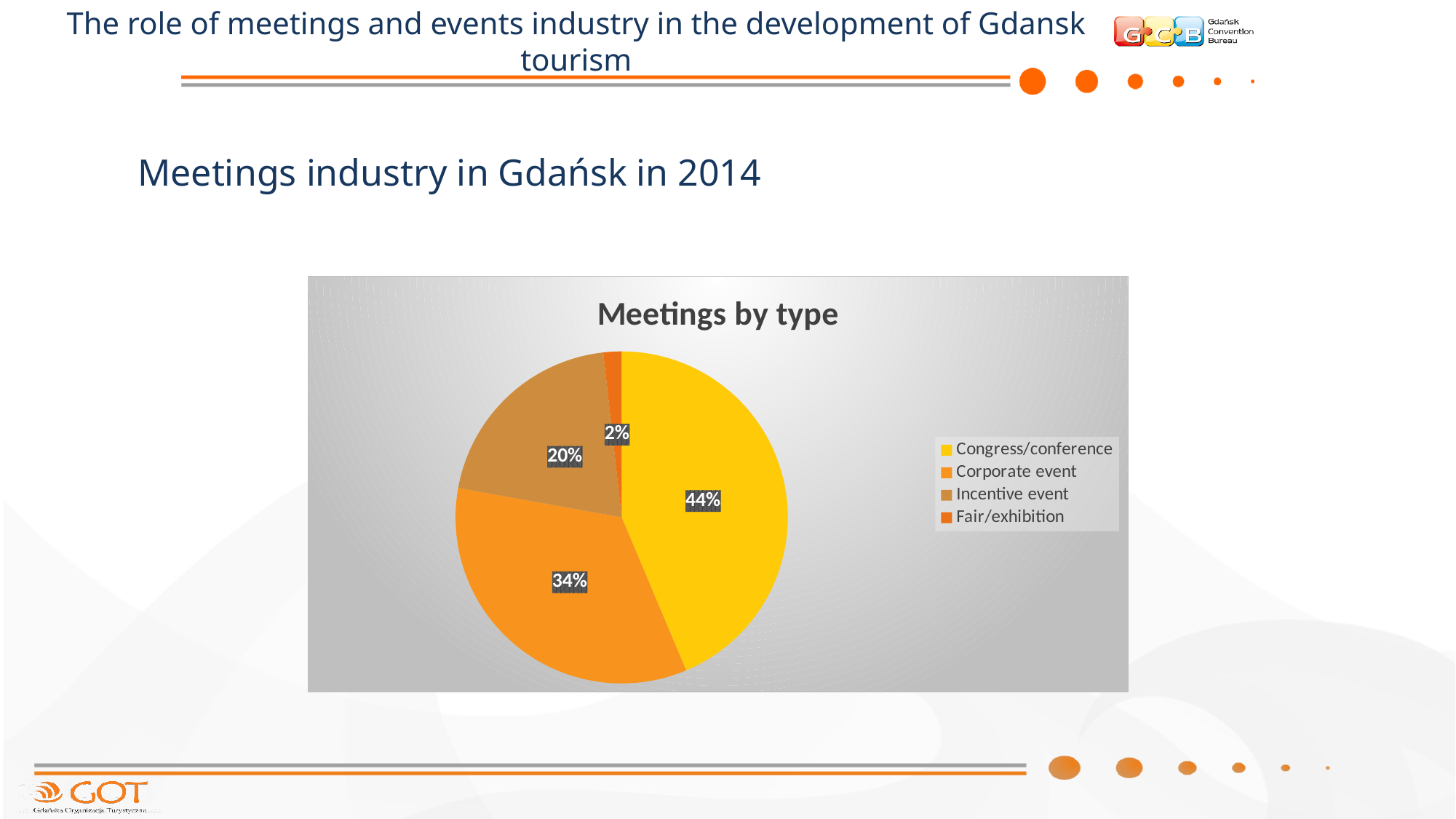
What type of chart is shown on the slide? pie chart What is the difference in percentage points between Congress/conference and Corporate event? 10 Which meeting type has the smallest share? Fair/exhibition Which is larger, the share for Incentive event or the share for Corporate event? Corporate event What share of meetings is Fair/exhibition? 2% What share of meetings is Congress/conference? 44% What share of meetings is Incentive event? 20% How many categories does the pie chart have? 4 What colour is the Congress/conference slice? yellow Which meeting type has the largest share? Congress/conference What is the title of the chart? Meetings by type What share of meetings is Corporate event? 34%